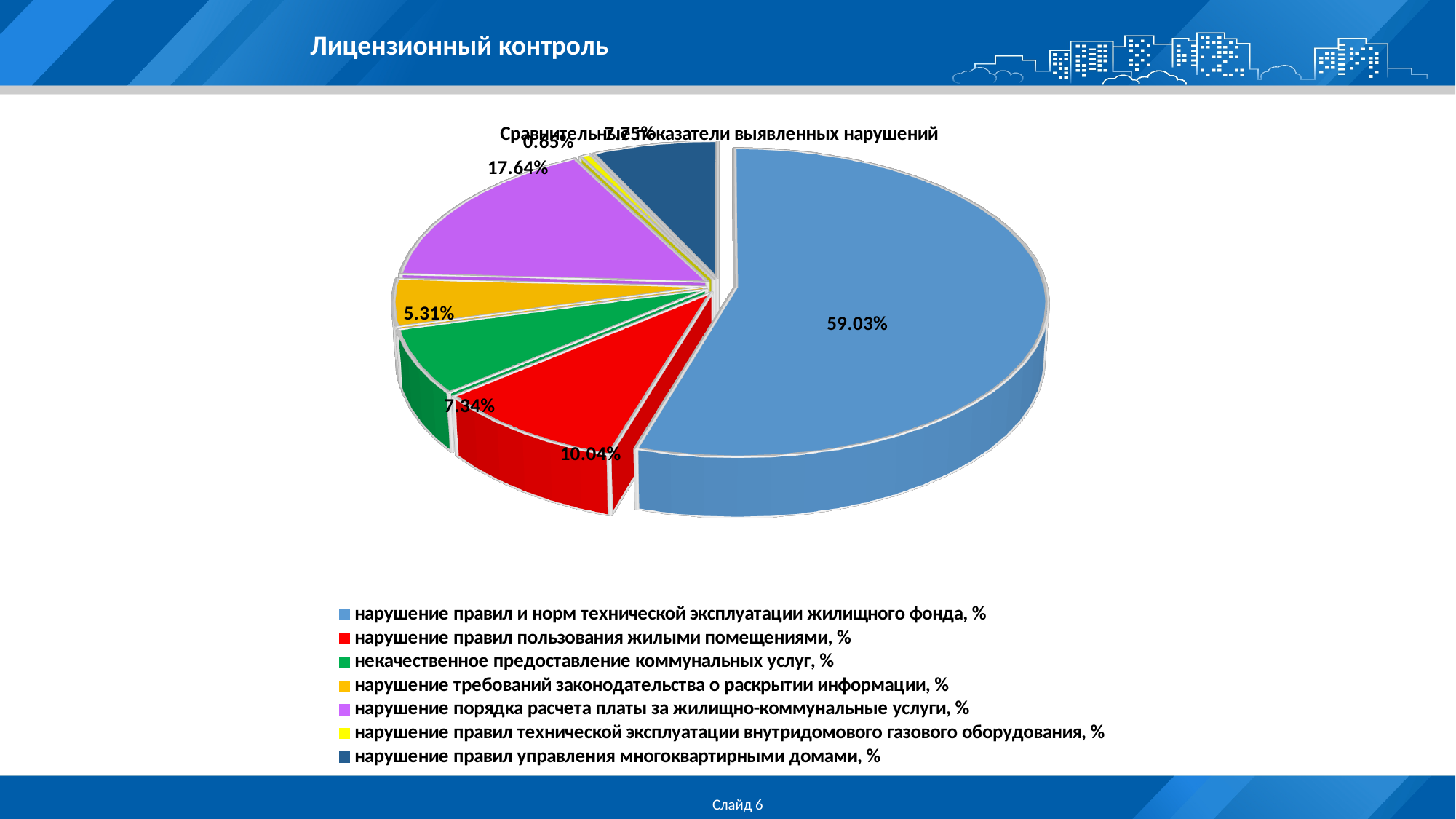
What share of the pie is labelled for 'нарушение правил и норм технической эксплуатации жилищного фонда, %'? 59.03% What value is shown for 'некачественное предоставление коммунальных услуг, %'? 7.34% What value is shown for 'нарушение требований законодательства о раскрытии информации, %'? 5.31% What colour is the slice representing the largest share? Light blue How many categories does the legend list? 7 Which category has the largest share of the pie? нарушение правил и норм технической эксплуатации жилищного фонда, % What is the difference in percentage points between the share for 'нарушение правил и норм технической эксплуатации жилищного фонда, %' and 'нарушение порядка расчета платы за жилищно-коммунальные услуги, %'? 41.39 What value is shown for 'нарушение порядка расчета платы за жилищно-коммунальные услуги, %'? 17.64% What type of chart is shown on the slide? Pie chart Which is larger: the share for 'нарушение правил пользования жилыми помещениями, %' or for 'некачественное предоставление коммунальных услуг, %'? нарушение правил пользования жилыми помещениями, % What value is shown for 'нарушение правил пользования жилыми помещениями, %'? 10.04% Which category has the smallest share of the pie? нарушение правил технической эксплуатации внутридомового газового оборудования, %